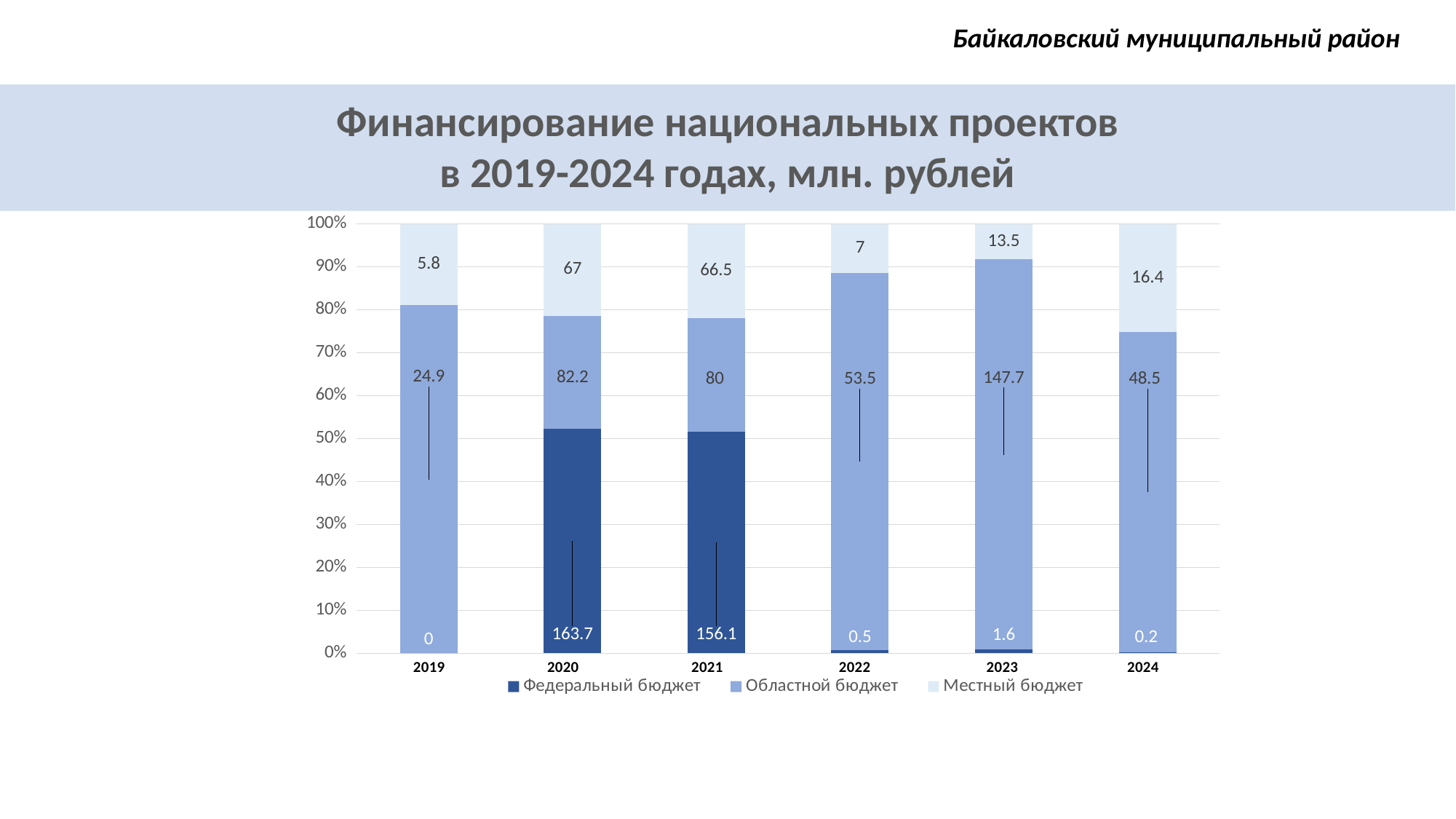
Which series is shown in the darkest blue colour? Федеральный бюджет How many years are shown on the x axis? 6 In which year is the Местный бюджет value lowest? 2019 How many series does the legend list? 3 What is the value for Областной бюджет in 2023? 147.7 In which year is the Федеральный бюджет value highest? 2020 What is the difference between the Областной бюджет values in 2020 and 2021? 2.2 What is the value for Местный бюджет in 2024? 16.4 What kind of chart is shown on the slide? Stacked bar chart What is the value for Федеральный бюджет in 2020? 163.7 Which is larger: the Местный бюджет value in 2020 or in 2021? 2020 What is the total of the three budget values for 2022? 61